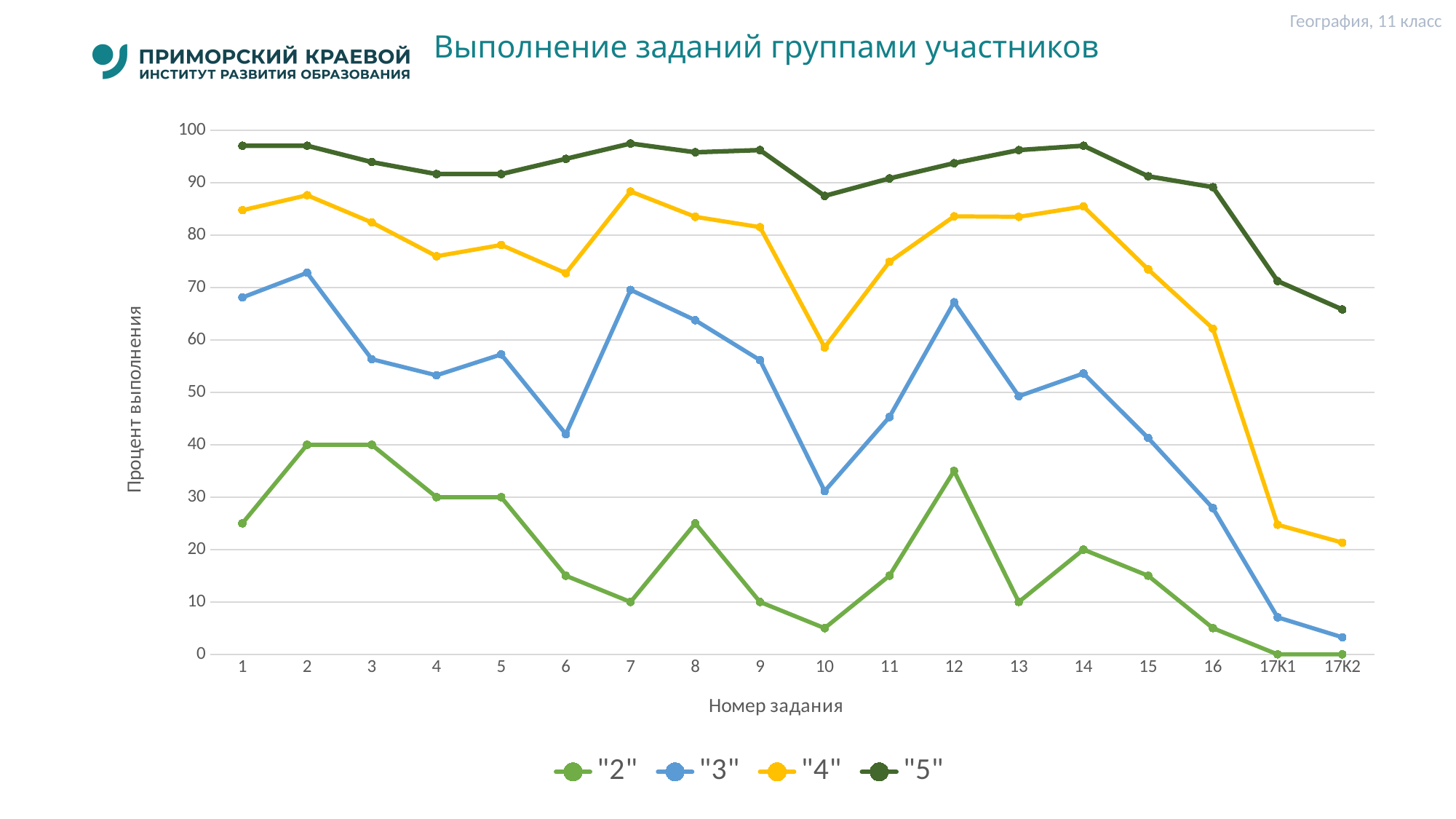
Is the value for series "5" at task 10 greater or less than 90? less Is the value for series "4" at task 7 greater or less than 80? greater What is the value for series "2" at task 2? 40 How many series does the legend list? 4 Which is larger for series "3": the value at task 7 or the value at task 6? task 7 Is the value for series "3" at task 10 greater or less than 40? less Which series has the highest values across the tasks? "5" What is the value for series "2" at task 14? 20 What is the value for series "2" at task 17К1? 0 What is the title of the y axis? Процент выполнения What kind of chart is shown on the slide? line chart How many task numbers are shown along the x axis? 18